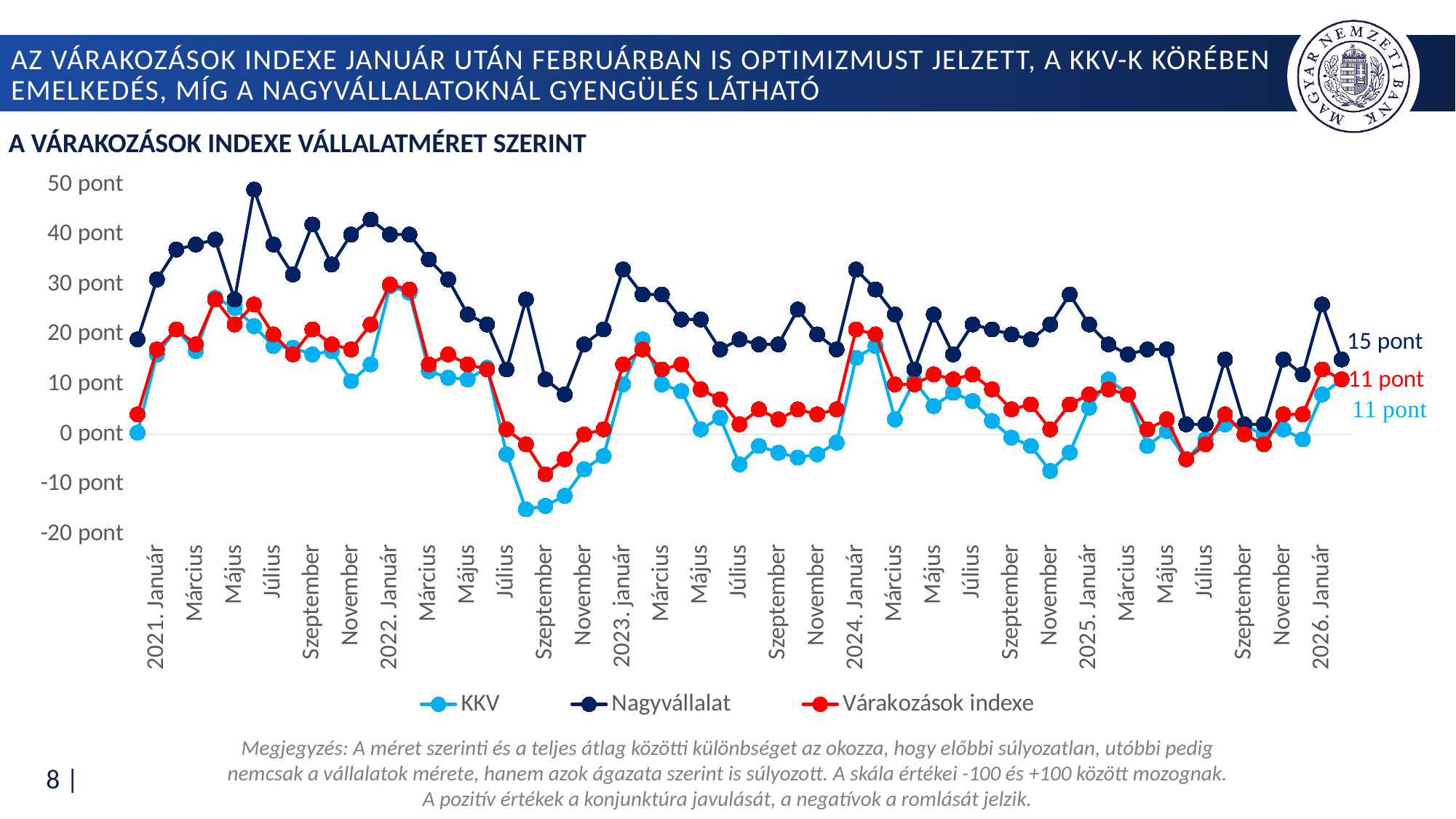
How many series does the legend list? 3 Is the lowest value of the KKV series greater or less than -10 pont? less What kind of chart is shown on the slide? line chart What is the title of the chart? A VÁRAKOZÁSOK INDEXE VÁLLALATMÉRET SZERINT Which series reaches the highest value anywhere on the chart? Nagyvállalat At the latest labelled point, how much higher is the Nagyvállalat value than the KKV value? 4 pont What are the three series named in the legend? KKV, Nagyvállalat, Várakozások indexe What is the latest labelled value of the Várakozások indexe series? 11 pont What is the latest labelled value of the KKV series? 11 pont What is the latest labelled value of the Nagyvállalat series? 15 pont At the latest labelled point, which is larger: the Nagyvállalat value or the KKV value? Nagyvállalat Is the peak value of the Nagyvállalat series in 2021 greater or less than 40 pont? greater